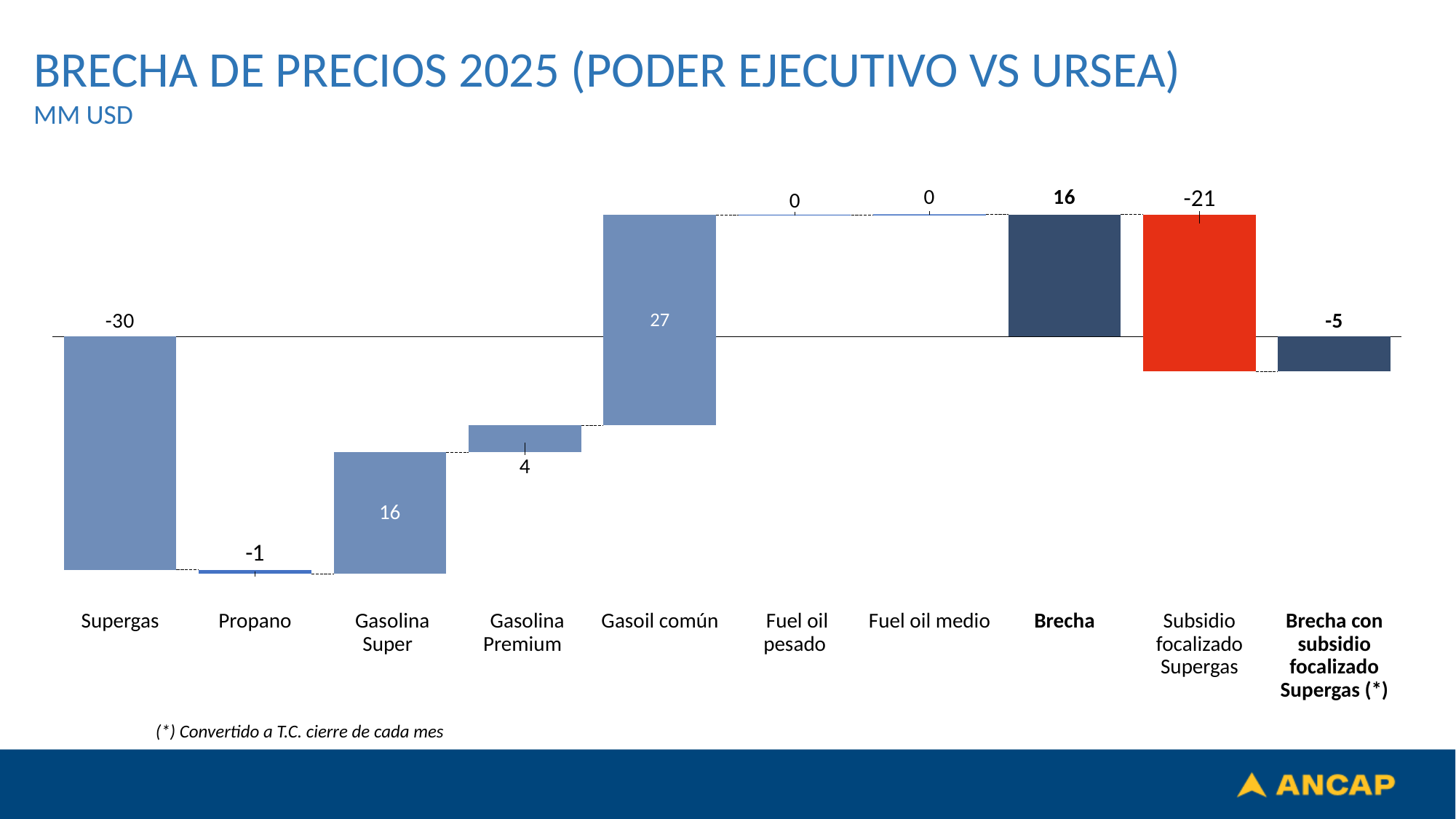
What kind of chart is shown on the slide? Waterfall bar chart What is the value for Gasolina Premium? 4 What is the value for Subsidio focalizado Supergas? -21 What is the value for Supergas? -30 What is the value for Gasoil común? 27 Which category has the lowest value? Supergas What is the difference between the values for Gasoil común and Gasolina Super? 11 What is the value for Brecha con subsidio focalizado Supergas (*)? -5 Which category has the highest value? Gasoil común Which is larger, the value for Gasolina Super or the value for Gasolina Premium? Gasolina Super How many categories are shown on the x axis? 10 What unit is stated below the chart title? MM USD